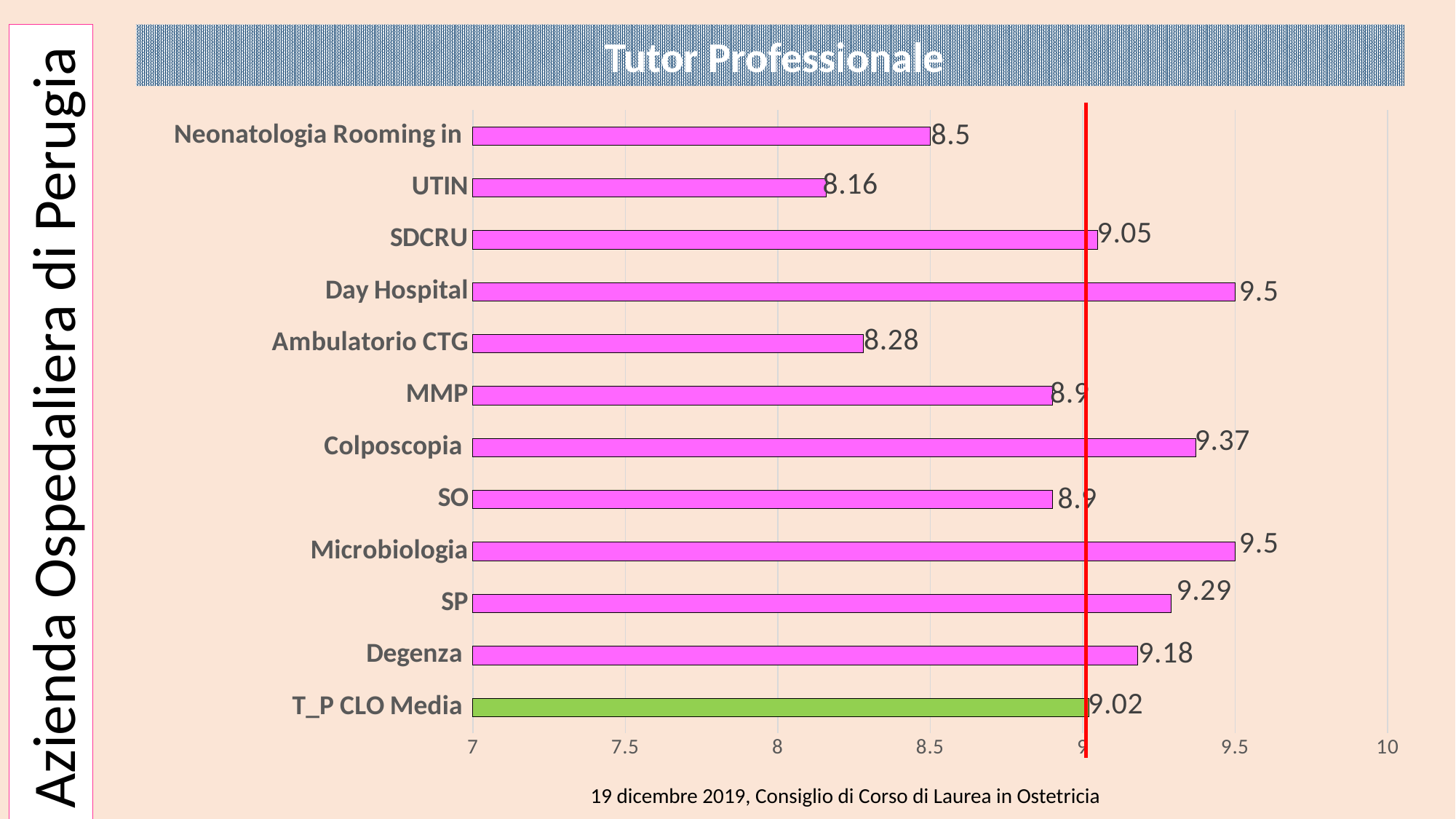
Is the value for MMP greater or less than 9? less What is the value for Degenza? 9.18 What is the difference between the values for Day Hospital and Ambulatorio CTG? 1.22 Which category has the lowest value? UTIN What is the title of the chart? Tutor Professionale Which is larger, the value for SDCRU or the value for Neonatologia Rooming in? SDCRU What kind of chart is shown on the slide? bar chart What is the value for UTIN? 8.16 How many categories are shown in the chart? 12 What is the value for Colposcopia? 9.37 What is the difference between the values for SP and Degenza? 0.11 What is the value for T_P CLO Media? 9.02